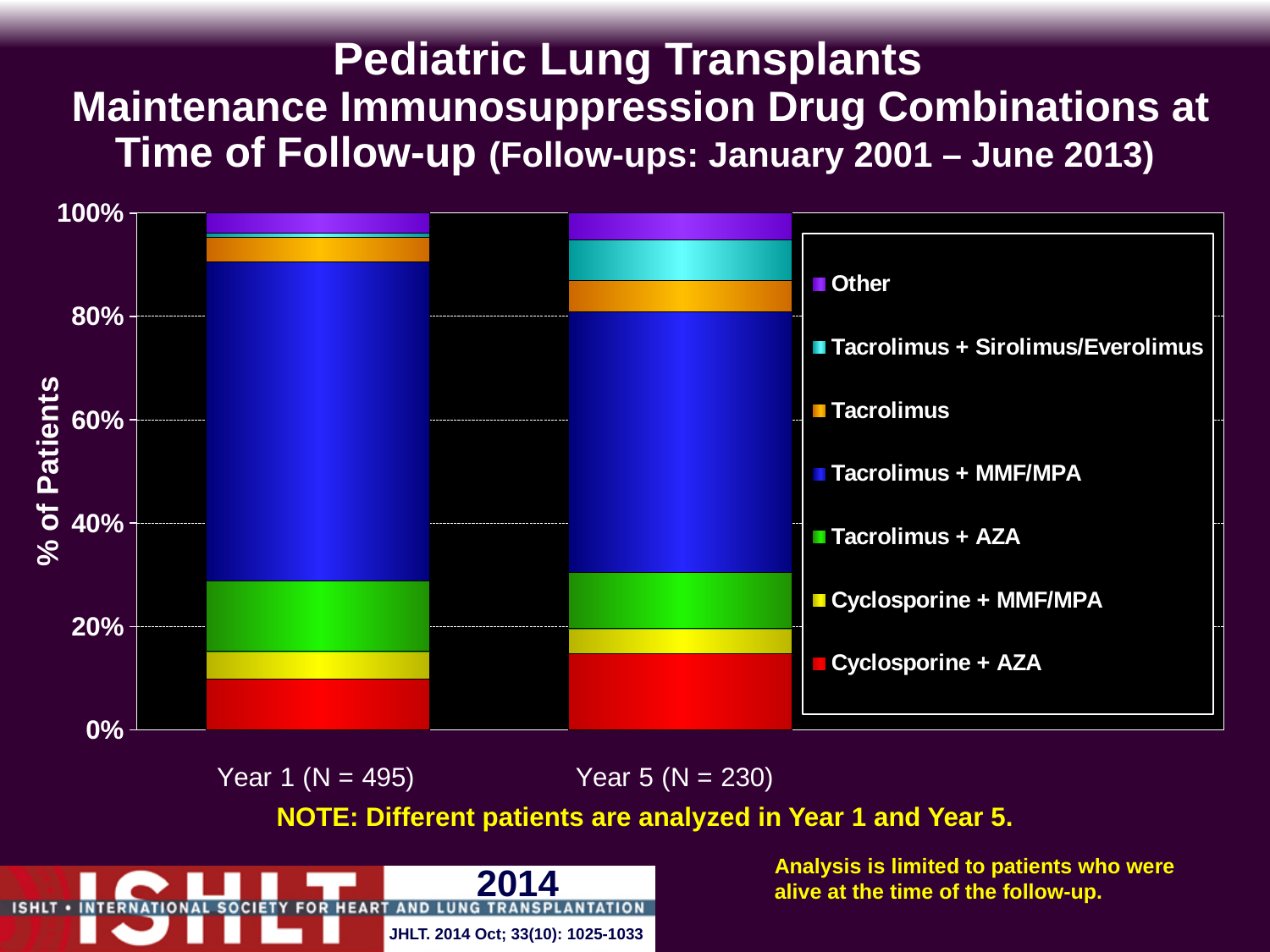
Is the share of Tacrolimus + MMF/MPA in the Year 5 bar greater or less than 60%? less What is the total height of the Year 1 stacked bar? 100% Which drug combination makes up the largest segment of the Year 1 (N = 495) bar? Tacrolimus + MMF/MPA How many bars (follow-up time points) are plotted on the chart? 2 Is the Tacrolimus + Sirolimus/Everolimus segment larger in the Year 1 bar or the Year 5 bar? Year 5 How many drug combination series does the legend list? 7 Is the share of Cyclosporine + AZA in the Year 1 bar greater or less than 20%? less What kind of chart is shown on the slide? Stacked bar chart Is the Tacrolimus + MMF/MPA segment larger in the Year 1 bar or the Year 5 bar? Year 1 What is the N (number of patients) shown for Year 5? 230 Is the share of Tacrolimus + MMF/MPA in the Year 1 bar greater or less than 40%? greater Which drug combination makes up the largest segment of the Year 5 (N = 230) bar? Tacrolimus + MMF/MPA